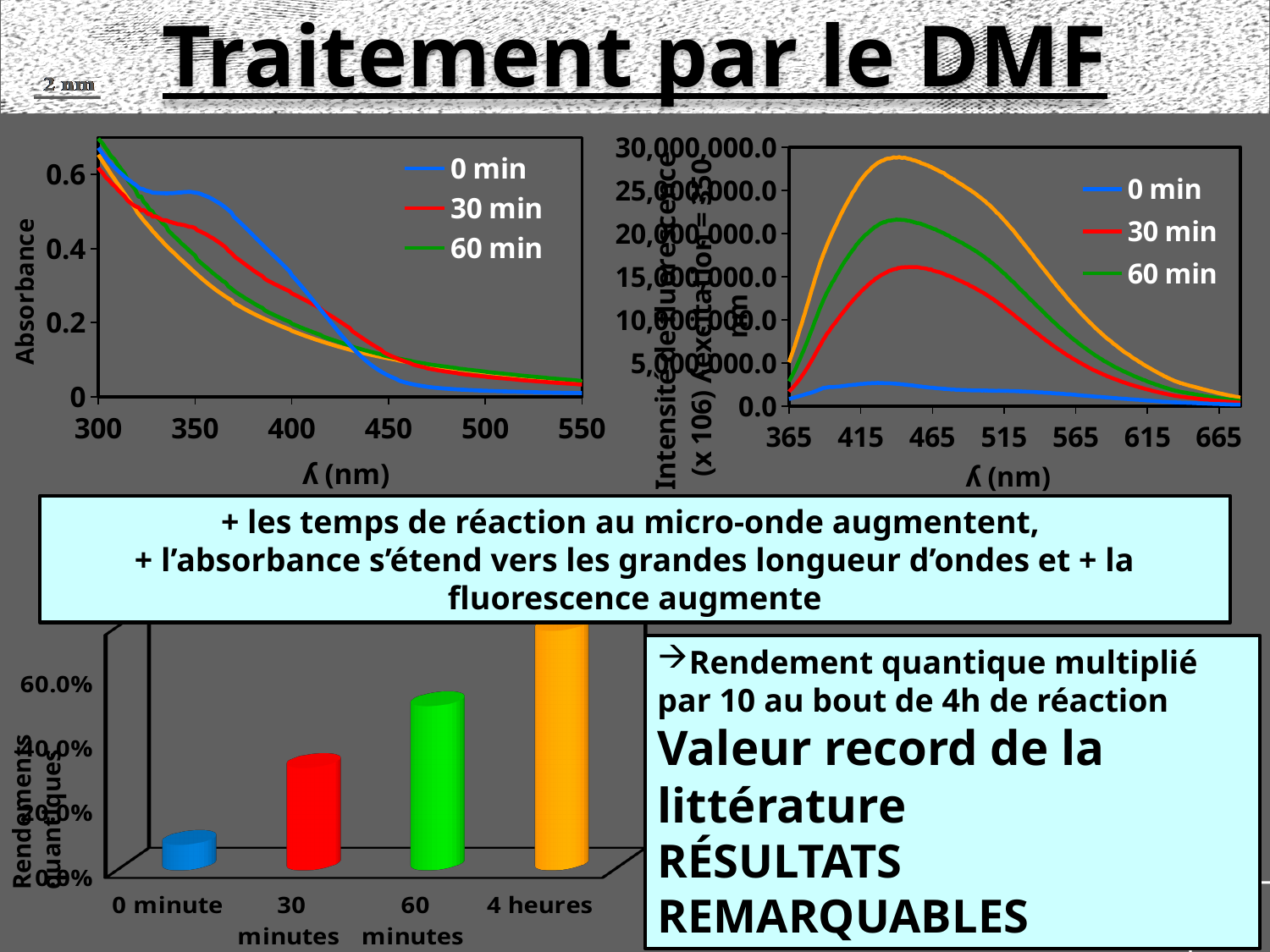
In the top-right fluorescence intensity chart, how many series does the legend list? 3 In the top-left Absorbance chart, do the values rise or fall as the wavelength increases along the x axis? fall What kind of chart is the top-left chart with the y-axis labelled Absorbance? line chart What kind of chart is the bottom-left chart showing Rendements quantiques? bar chart In the top-right fluorescence intensity chart, is the peak value of the 0 min series greater or less than 5,000,000.0? less In the bottom-left Rendements quantiques bar chart, how many categories are shown on the x axis? 4 In the bottom-left Rendements quantiques bar chart, which category has the highest value? 4 heures In the top-left Absorbance chart, is the value for 0 min at 300 nm greater or less than 0.6? greater In the top-left Absorbance chart, is the value for 0 min at 500 nm greater or less than 0.2? less In the top-left Absorbance chart, how many series does the legend list? 3 In the top-right fluorescence intensity chart, which series reaches a higher peak, 30 min or 60 min? 60 min